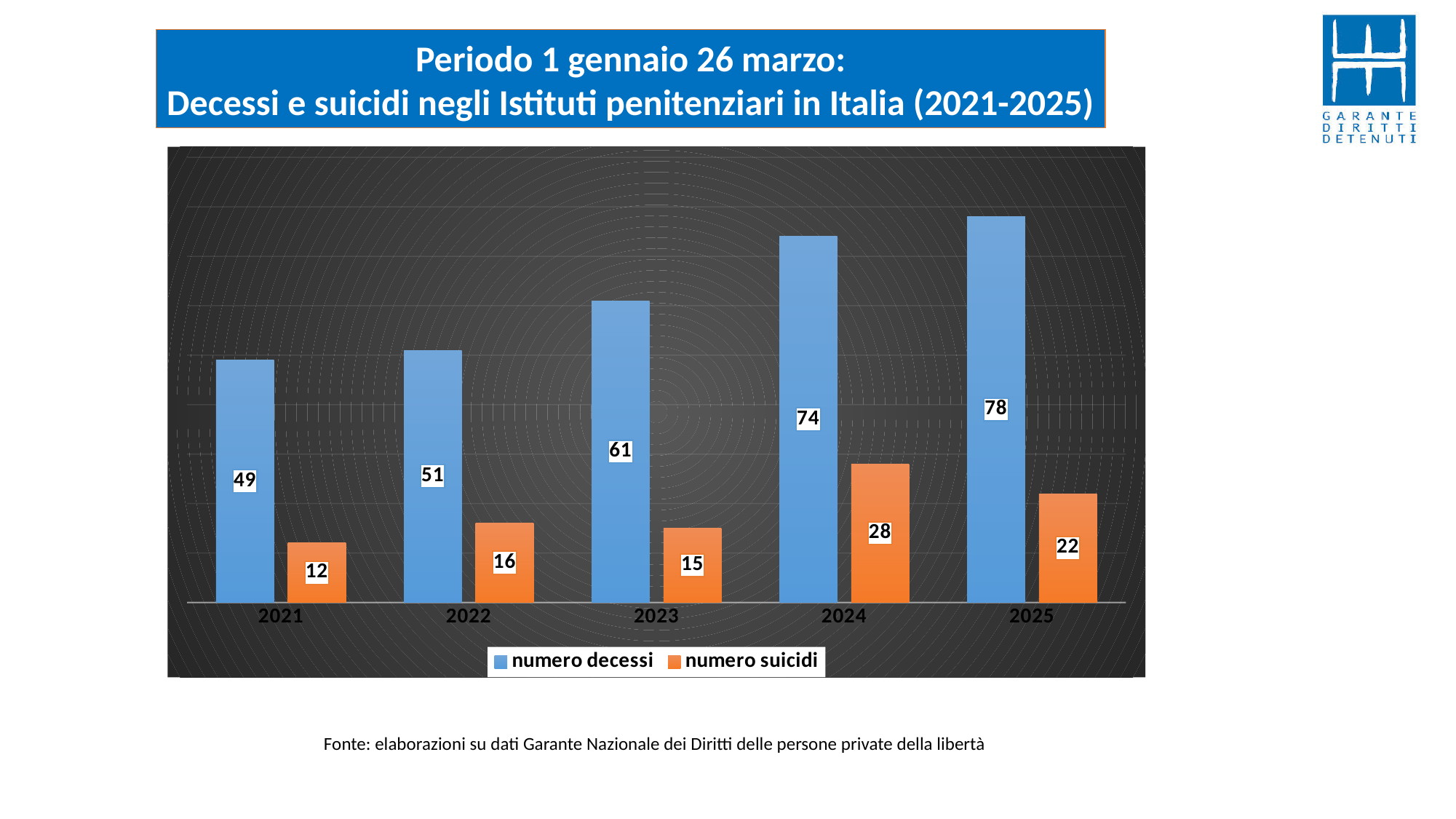
Which year has the lowest numero suicidi? 2021 What is the difference between numero decessi and numero suicidi in 2025? 56 How many years are shown on the x axis? 5 Which year has the highest numero decessi? 2025 What is the value of numero suicidi for 2024? 28 What is the difference in numero suicidi between 2024 and 2023? 13 What is the value of numero decessi for 2023? 61 What is the value of numero suicidi for 2021? 12 Which is larger: numero suicidi in 2022 or numero suicidi in 2025? 2025 What kind of chart is shown on the slide? bar chart Does numero decessi rise or fall from 2021 to 2025? rise How many series does the legend list? 2